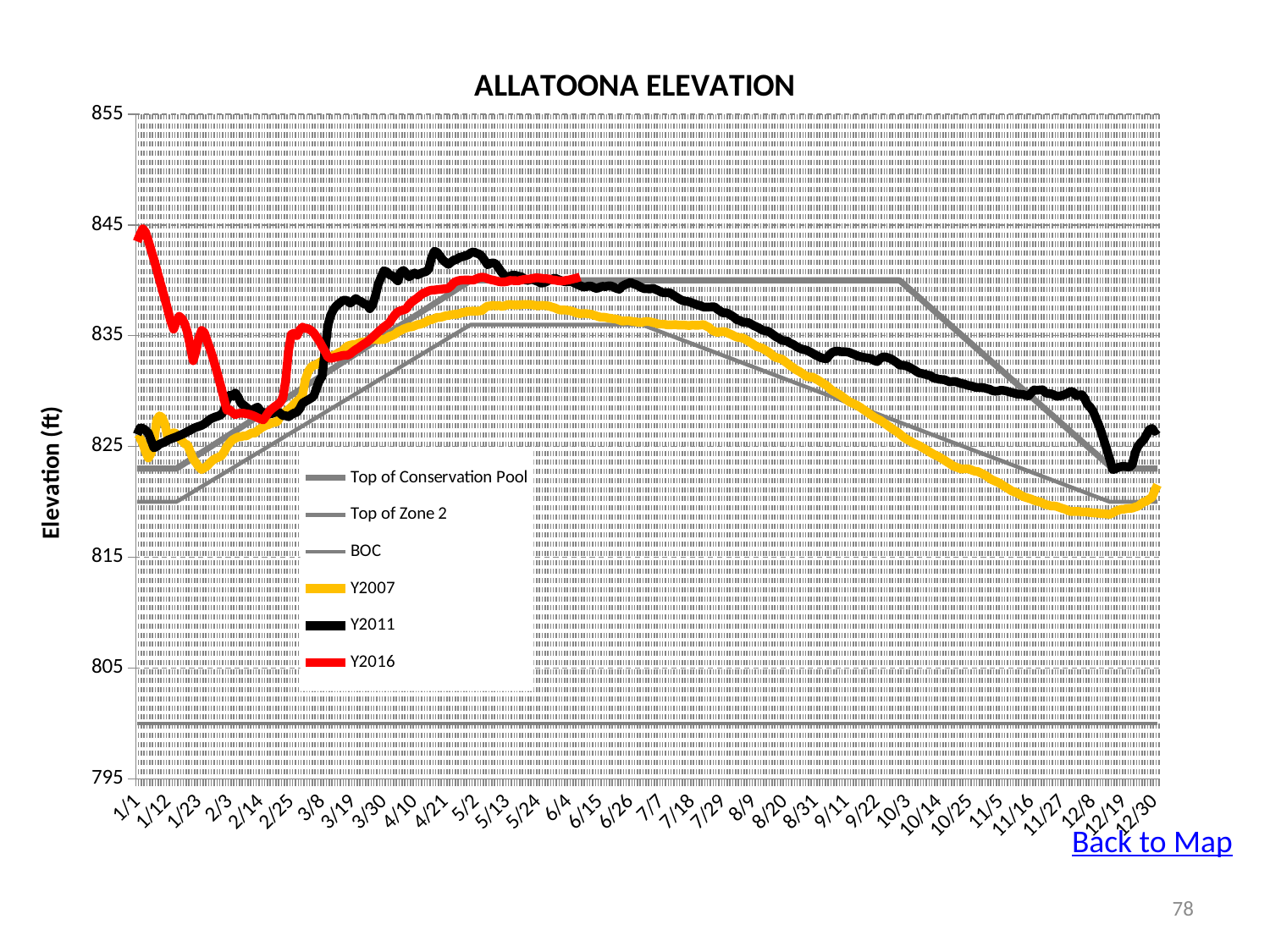
Does the Y2011 line rise or fall between 3/8 and 5/2? rise Is the value for Y2016 on 1/1 greater or less than 840? greater Is the value for Y2007 on 12/8 greater or less than 825? less Is the value for Top of Conservation Pool on 8/9 greater or less than 835? greater Which series is plotted in red? Y2016 What kind of chart is shown on the slide? line chart How many series does the legend list? 6 Does the Y2007 line rise or fall between 7/29 and 12/8? fall On 1/1, which series has the higher value, Y2016 or Y2011? Y2016 What is the title of the chart? ALLATOONA ELEVATION On 10/14, which series has the higher value, Y2011 or Y2007? Y2011